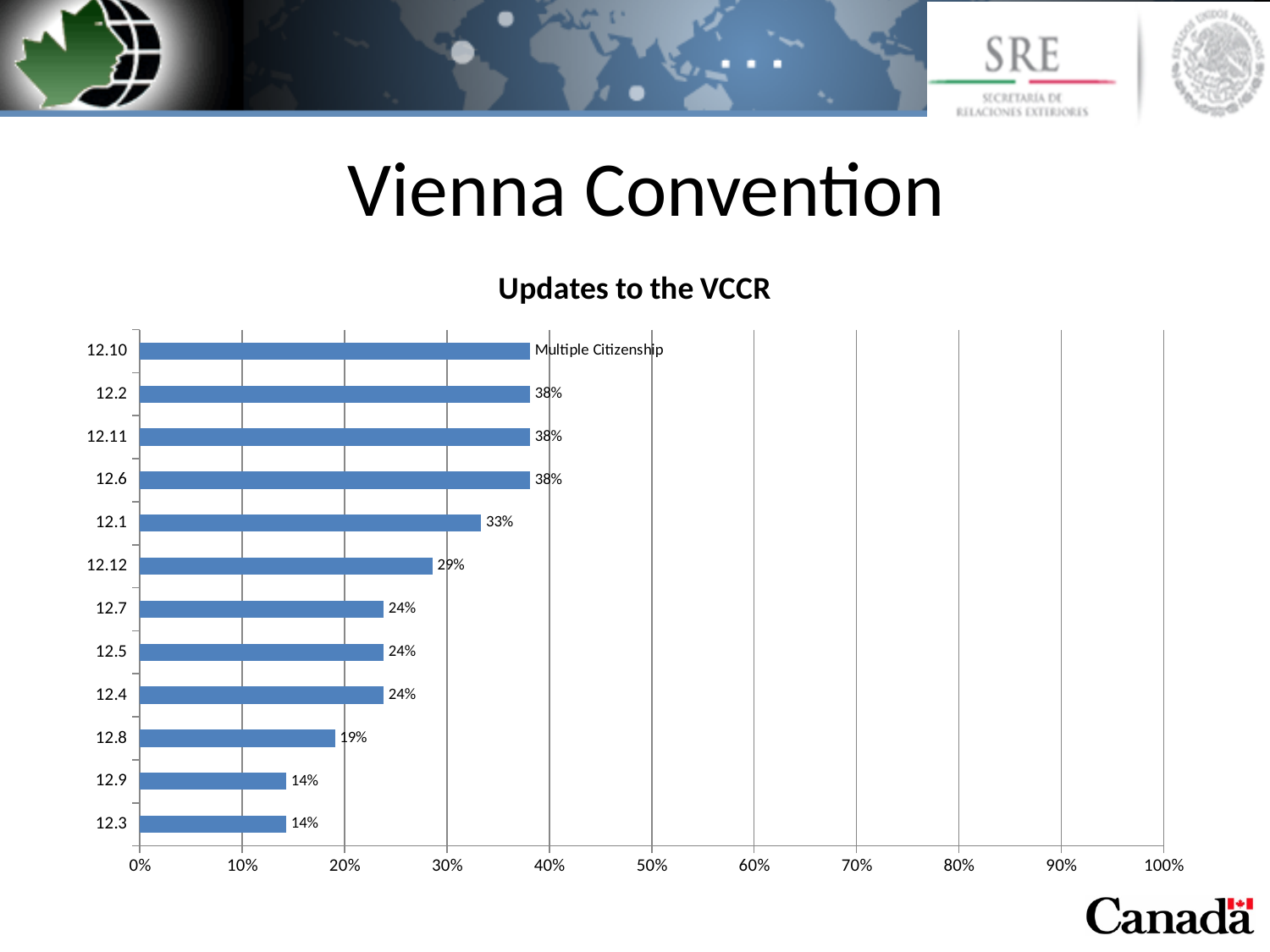
How many categories are plotted in the chart? 12 What text label is shown next to the bar for 12.10? Multiple Citizenship What is the title of the chart? Updates to the VCCR What is the difference between the values for 12.1 and 12.12? 4% What kind of chart is shown on the slide? bar chart What is the value for 12.12? 29% Which has the larger value, 12.1 or 12.8? 12.1 What is the value for 12.1? 33% What is the lowest value shown in the chart? 14% Is the value for 12.10 greater or less than 30%? greater What is the value for 12.8? 19% What is the value for 12.6? 38%